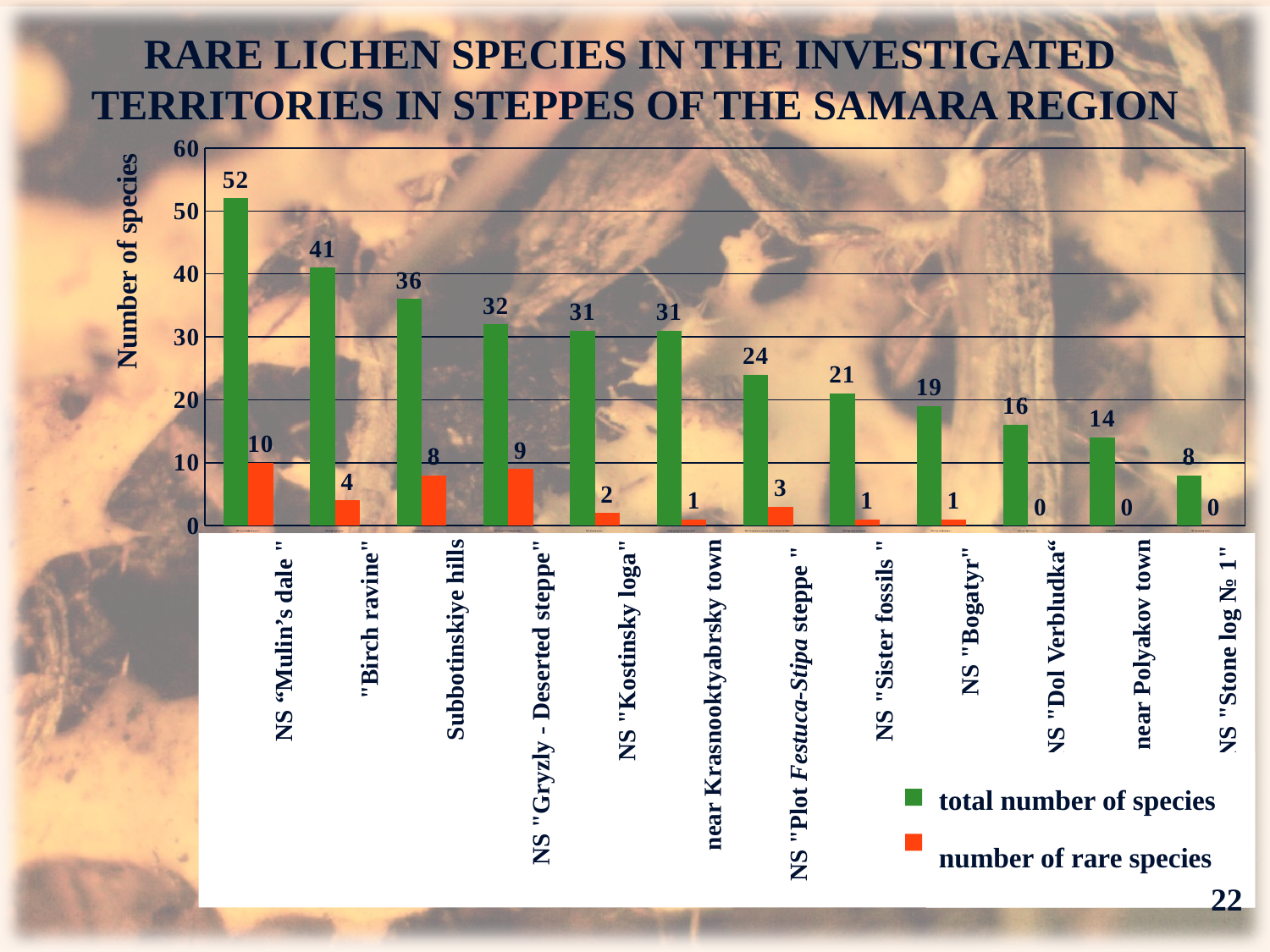
Which territory has the highest total number of species? NS "Mulin's dale" What is the total number of species near Krasnooktyabrsky town? 31 What is the number of rare species for Subbotinskiye hills? 8 Which has a larger total number of species, NS "Bogatyr" or NS "Dol Verbludka"? NS "Bogatyr" How many series does the legend list? 2 How many territories are shown on the x axis? 12 Which territory has the lowest total number of species? NS "Stone log № 1" Which territory has the highest number of rare species? NS "Mulin's dale" What is the difference between the total number of species and the number of rare species for "Birch ravine"? 37 What is the total number of species for NS "Mulin's dale"? 52 What kind of chart is shown on the slide? bar chart Do the total number of species values rise or fall from left to right along the x axis? fall